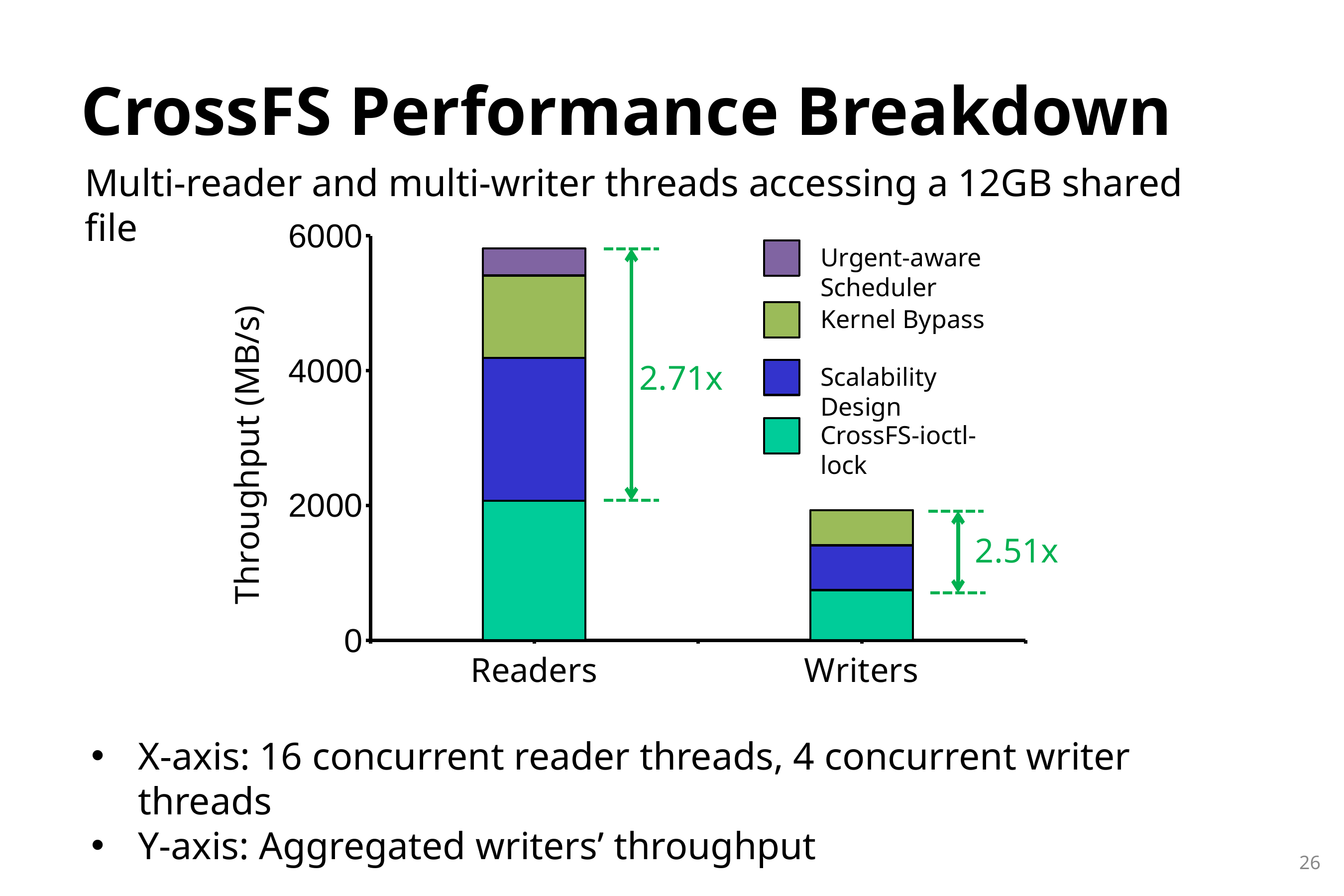
How many series does the legend list? 4 What improvement factor is annotated next to the Readers bar? 2.71x How many categories are shown on the x axis? 2 Is the total throughput for Readers greater or less than 4000? greater Which category has the lower total throughput? Writers Is the Scalability Design segment larger for Readers or for Writers? Readers What kind of chart is shown on the slide? stacked bar chart What improvement factor is annotated next to the Writers bar? 2.51x Is the total throughput for Writers greater or less than 4000? less Is the CrossFS-ioctl-lock value for Writers greater or less than 2000? less Which category has the higher total throughput, Readers or Writers? Readers